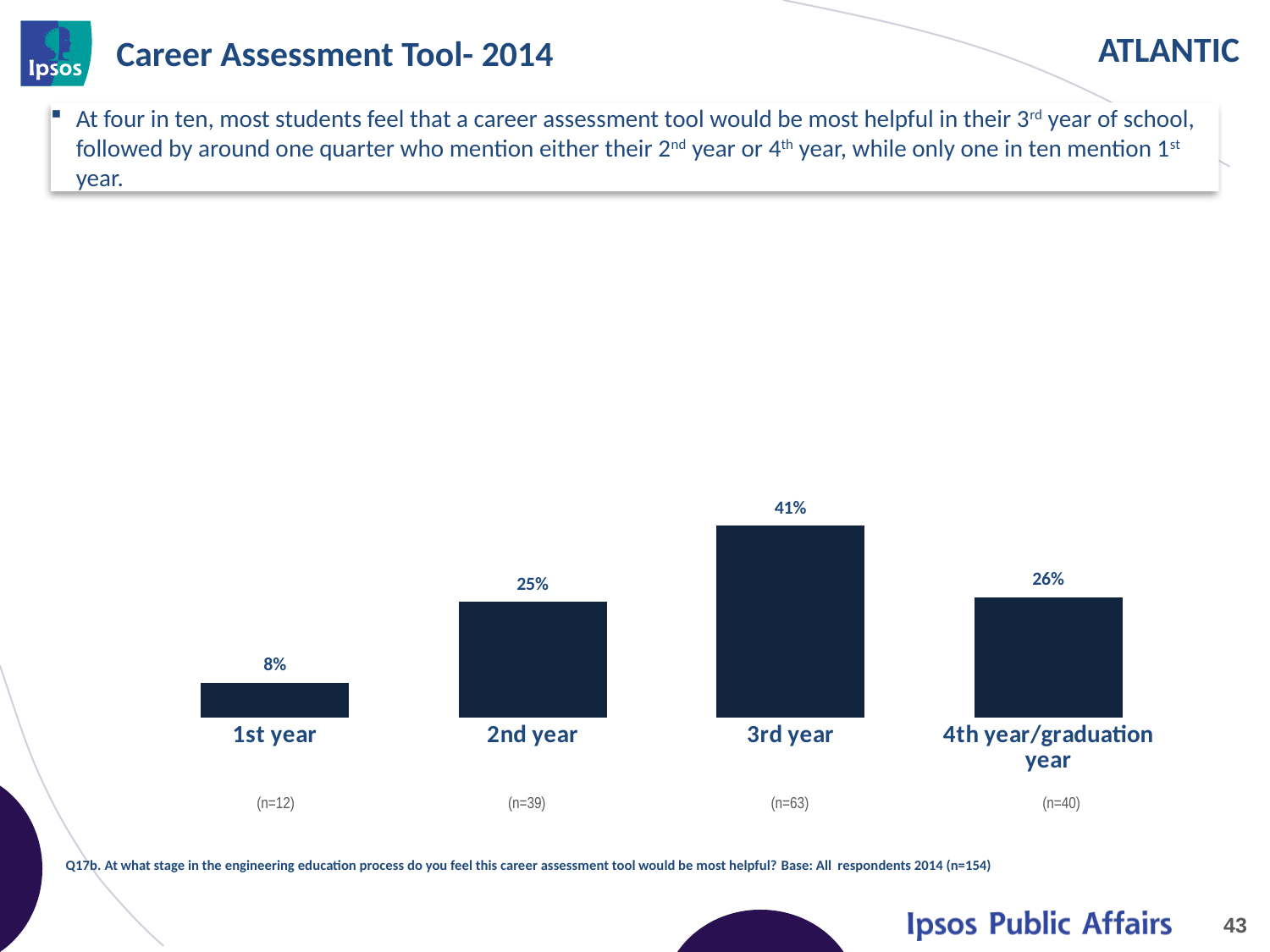
How many categories are shown on the chart? 4 What is the value shown for 4th year/graduation year? 26% What percentage of students feel the career assessment tool would be most helpful in their 3rd year? 41% What is the sample size (n) shown under the 3rd year bar? (n=63) What is the value shown for 1st year? 8% Which is larger, the value for 2nd year or the value for 3rd year? 3rd year What is the title of the slide containing the chart? Career Assessment Tool- 2014 What kind of chart is shown on the slide? Bar chart What is the difference in percentage points between 4th year/graduation year and 2nd year? 1 What is the difference in percentage points between 3rd year and 1st year? 33 Which year has the lowest percentage? 1st year Which year has the highest percentage? 3rd year